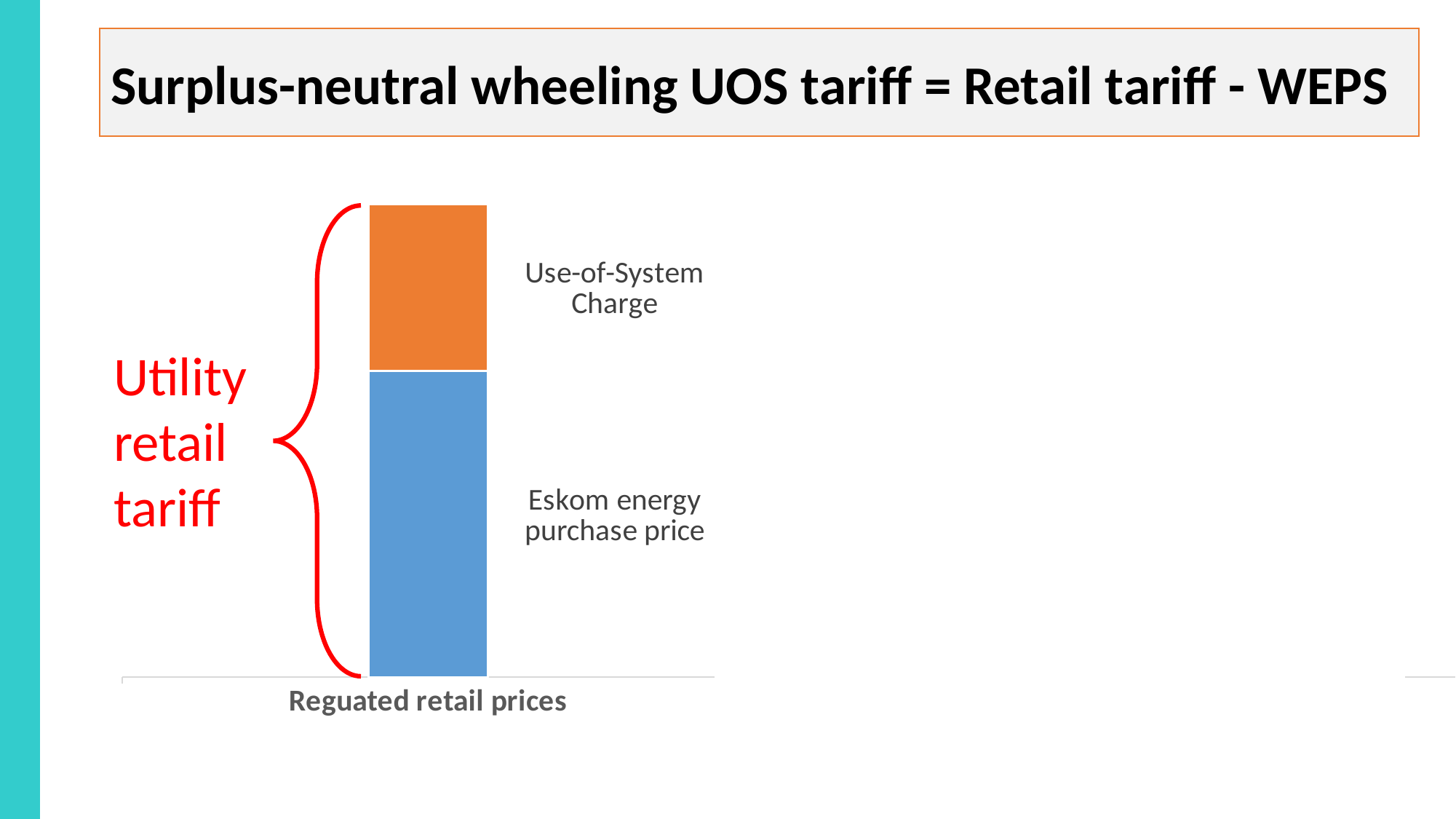
How many segments make up the stacked bar in the chart? 2 What is the label of the single category on the x axis? Reguated retail prices What kind of chart is shown on the slide? stacked bar chart Which segment of the stacked bar is the smallest? Use-of-System Charge Which segment of the stacked bar is the largest? Eskom energy purchase price Which segment of the stacked bar is larger, the Use-of-System Charge or the Eskom energy purchase price? Eskom energy purchase price How many categories are shown on the x axis of the chart? 1 Which segment sits at the bottom of the stacked bar? Eskom energy purchase price What colour is the Use-of-System Charge segment of the bar? orange